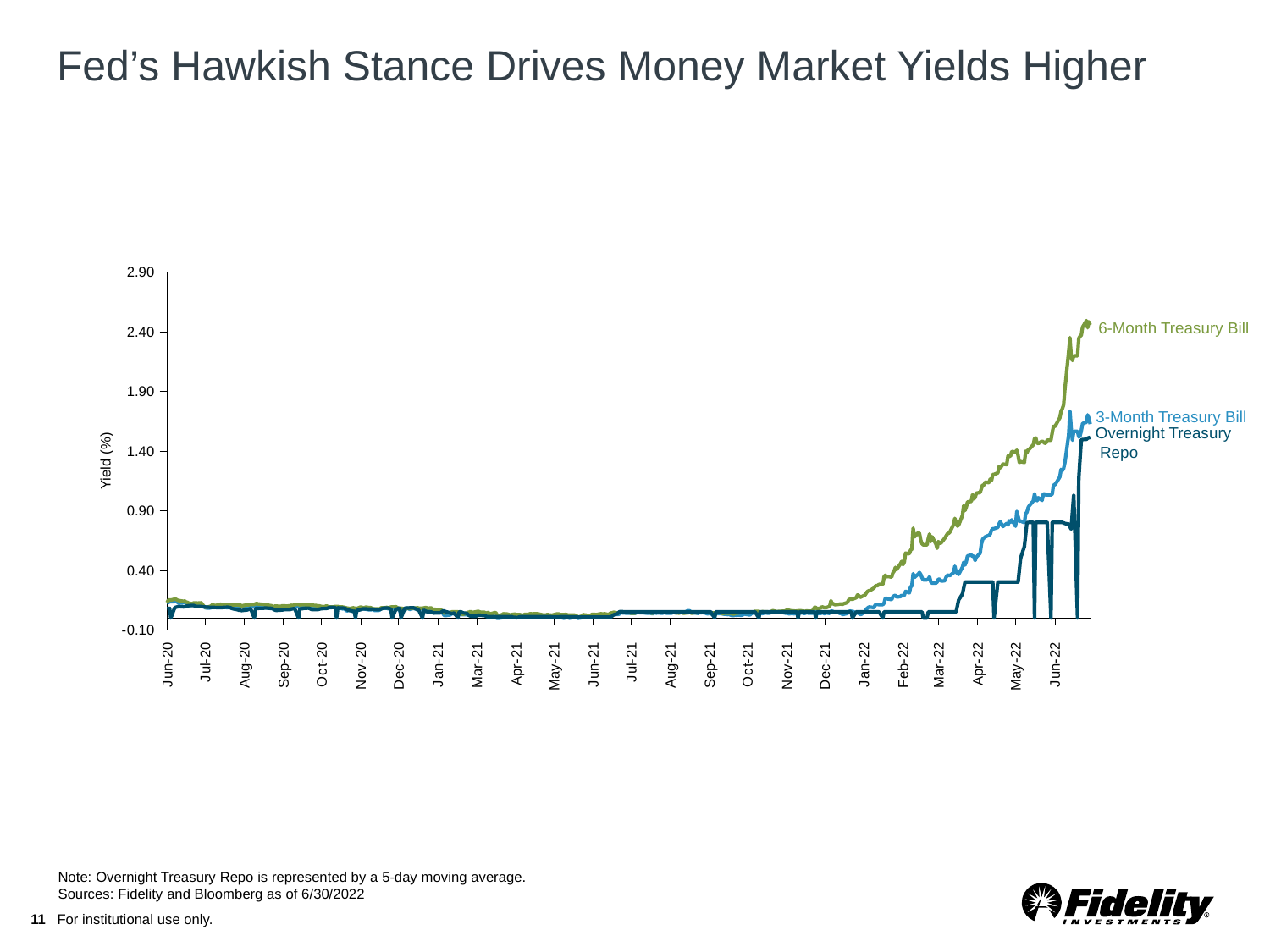
What is the label on the vertical axis? Yield (%) How many series are plotted on the chart? 3 What kind of chart is shown on the slide? Line chart At Jun-21, is the yield of the 6-Month Treasury Bill greater or less than 0.40? less At Jun-22, is the yield of the 6-Month Treasury Bill greater or less than 1.90? greater What is the title of the chart? Fed's Hawkish Stance Drives Money Market Yields Higher Which series has the lowest yield at the end of the chart (Jun-22)? Overnight Treasury Repo Which series reaches the highest yield at the end of the chart (Jun-22)? 6-Month Treasury Bill At Jun-22, is the yield of the 3-Month Treasury Bill greater or less than 1.90? less At Jun-22, which is higher: the 6-Month Treasury Bill or the 3-Month Treasury Bill? 6-Month Treasury Bill Do the yields rise or fall between Dec-21 and Jun-22? Rise